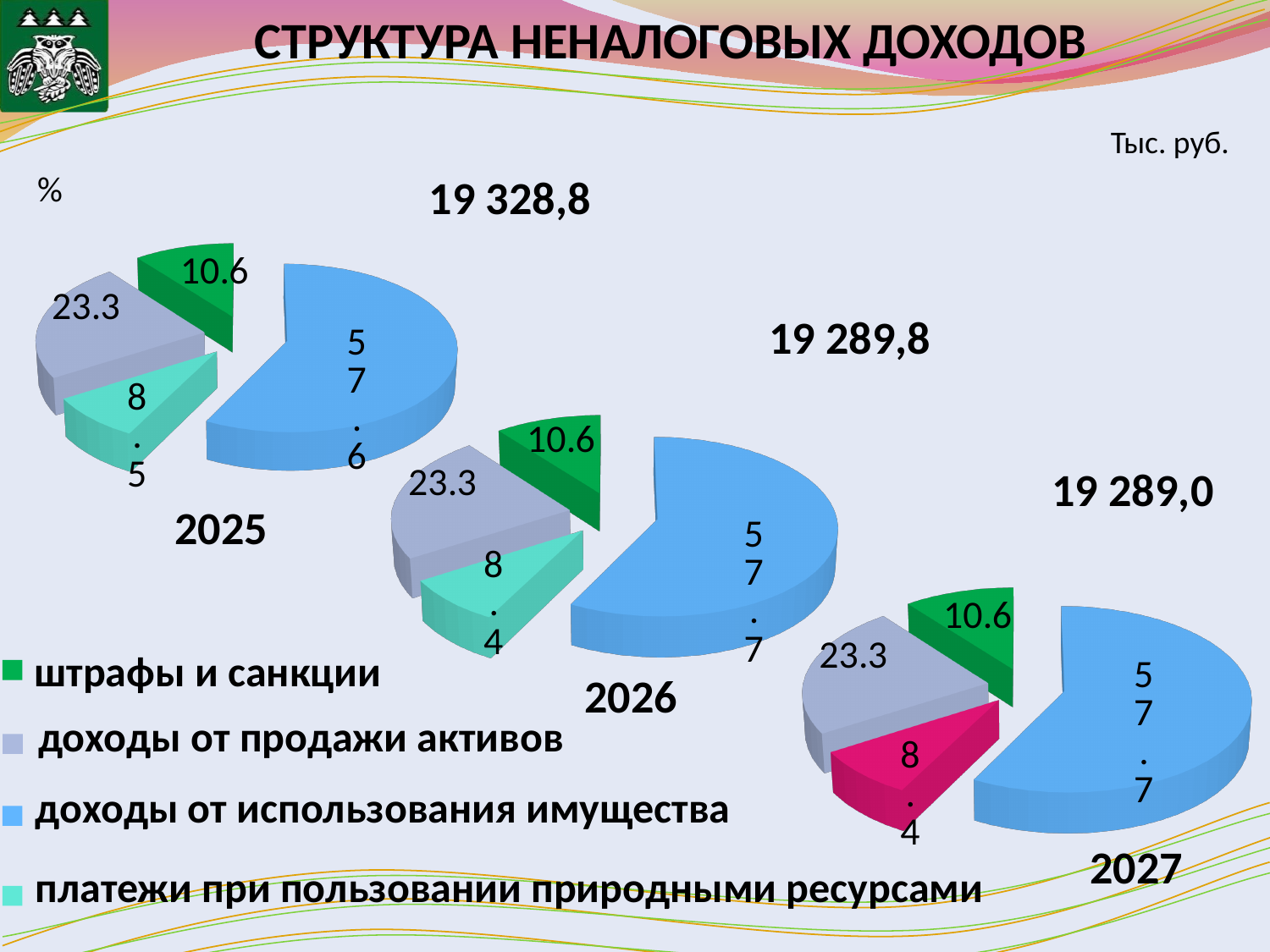
Which category has the largest share in the 2025 pie chart? доходы от использования имущества How many categories does the legend list? 4 In the 2025 pie chart, what is the share of платежи при пользовании природными ресурсами? 8.5 Which category has the smallest share in the 2026 pie chart? платежи при пользовании природными ресурсами In the 2026 pie chart, what is the share of платежи при пользовании природными ресурсами? 8.4 What type of chart is used on this slide to show the structure of non-tax revenues? pie chart How many pie charts are shown on the slide? 3 In the 2026 pie chart, what is the share of доходы от использования имущества? 57.7 In the 2027 pie chart, what is the share of доходы от продажи активов? 23.3 What total amount (тыс. руб.) is shown above the 2025 pie chart? 19 328,8 In the 2025 pie chart, what is the share of доходы от использования имущества? 57.6 In the 2027 pie chart, what is the share of штрафы и санкции? 10.6